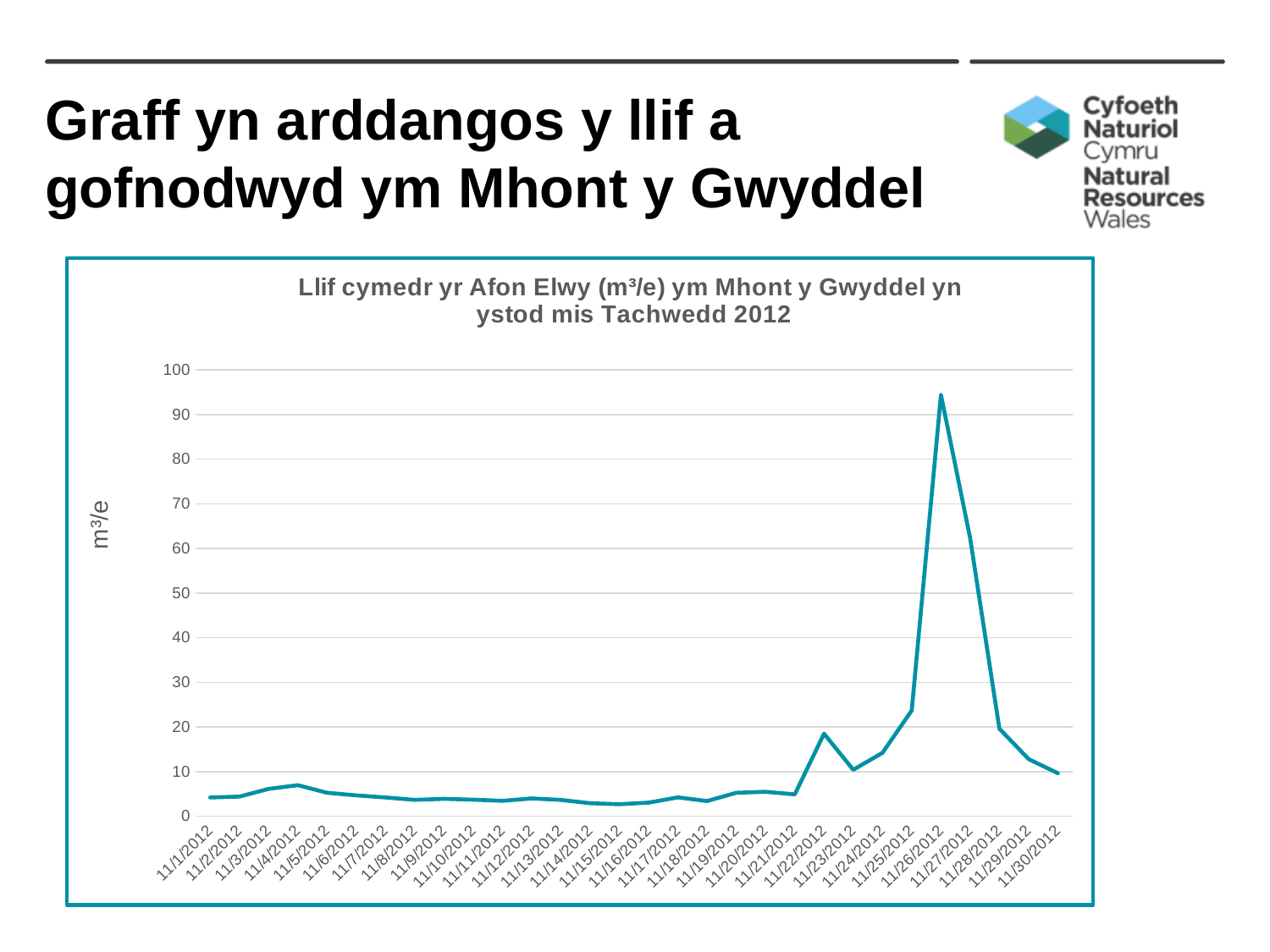
Do the values rise or fall from 11/26/2012 to 11/30/2012? fall On which date does the river flow reach its highest value? 11/26/2012 Is the value for 11/26/2012 greater or less than 90? greater Is the value for 11/1/2012 greater or less than 10? less What kind of chart is shown on the slide? line chart Which date has the larger flow value, 11/26/2012 or 11/27/2012? 11/26/2012 Which date has the larger flow value, 11/22/2012 or 11/23/2012? 11/22/2012 How many dates are plotted along the x axis of the chart? 30 What label is shown on the vertical axis of the chart? m³/e Is the value for 11/27/2012 greater or less than 50? greater